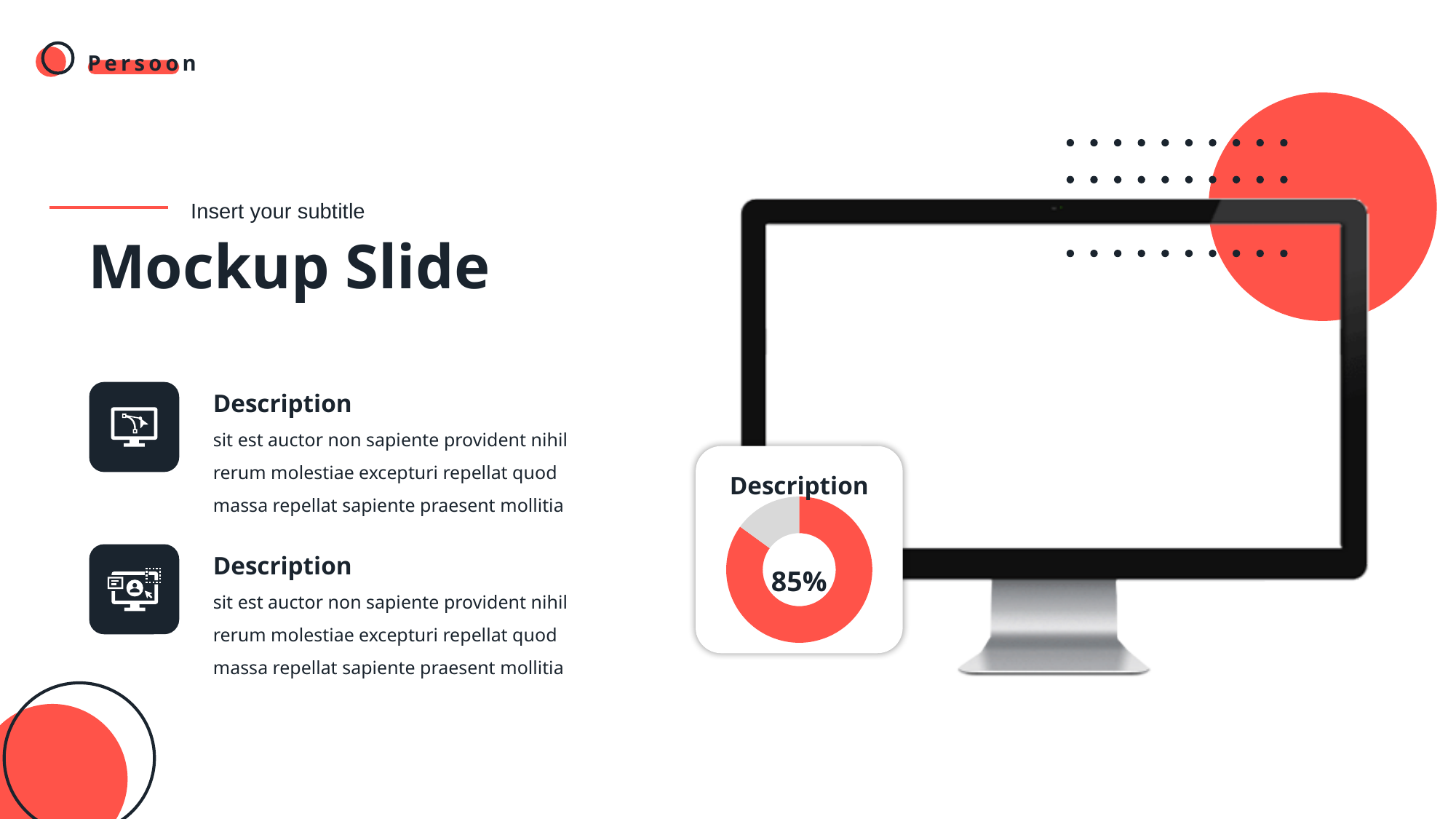
What percentage is printed in the centre of the doughnut chart? 85% How many segments does the doughnut chart have? 2 What kind of chart is shown in the card labelled "Description"? Doughnut (pie) chart What share of the doughnut chart does the red segment represent? 85% Is the value shown in the doughnut chart greater or less than 50%? greater What is the title printed above the doughnut chart? Description Which segment of the doughnut chart is larger, the red one or the grey one? The red one What share of the doughnut chart does the grey segment represent? 15% What colour is the larger segment of the doughnut chart? Red